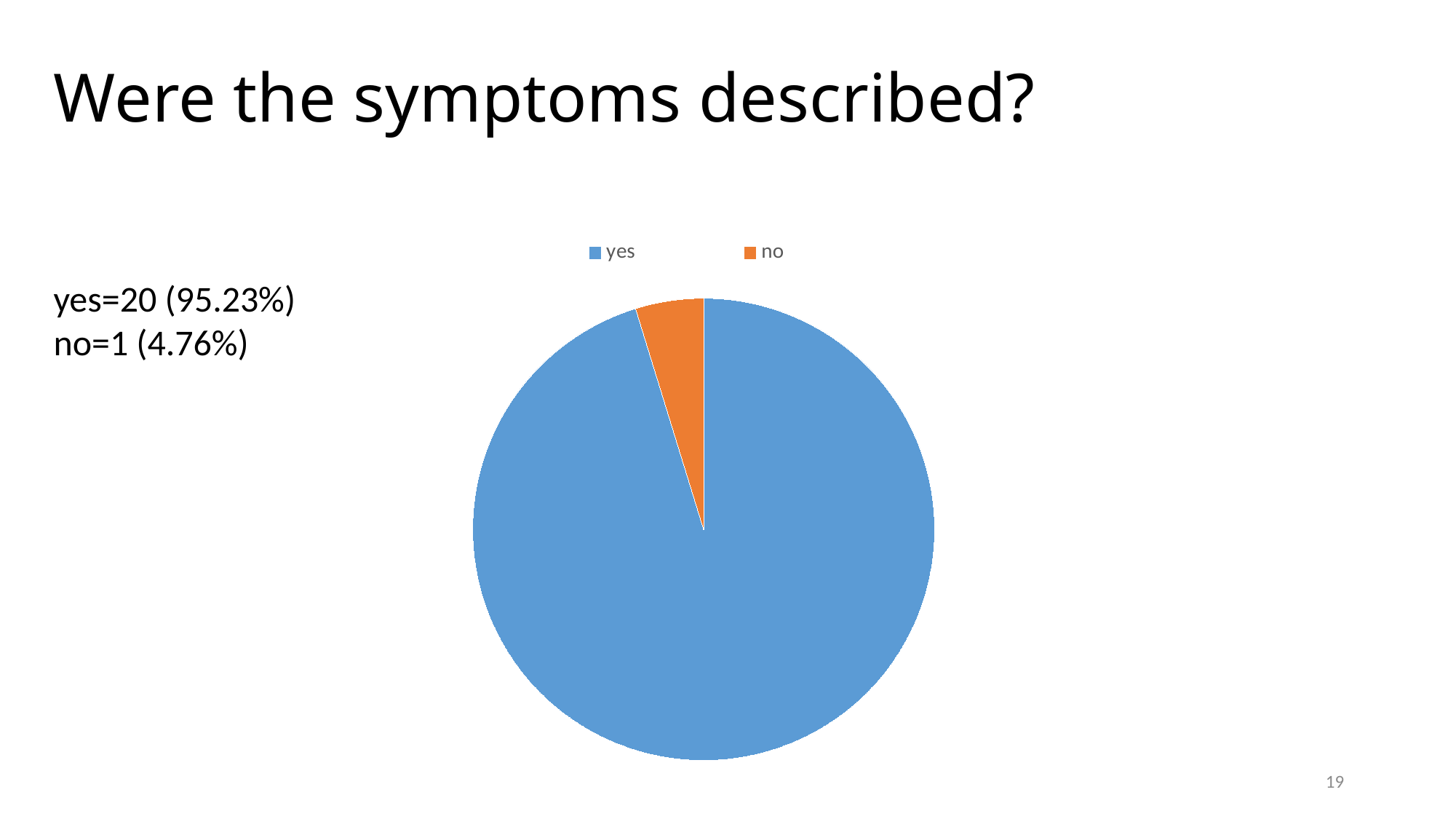
What colour is the "no" slice? orange How many categories does the pie chart have? 2 Which category has the smallest slice? no Which is larger, the slice for "yes" or the slice for "no"? yes What share of the pie does "yes" represent? 95.23% Which category has the largest slice? yes What share of the pie does "no" represent? 4.76% What is the count for "no"? 1 What is the count for "yes"? 20 What kind of chart is shown on the slide? pie chart How many entries does the legend list? 2 What is the difference between the counts for "yes" and "no"? 19